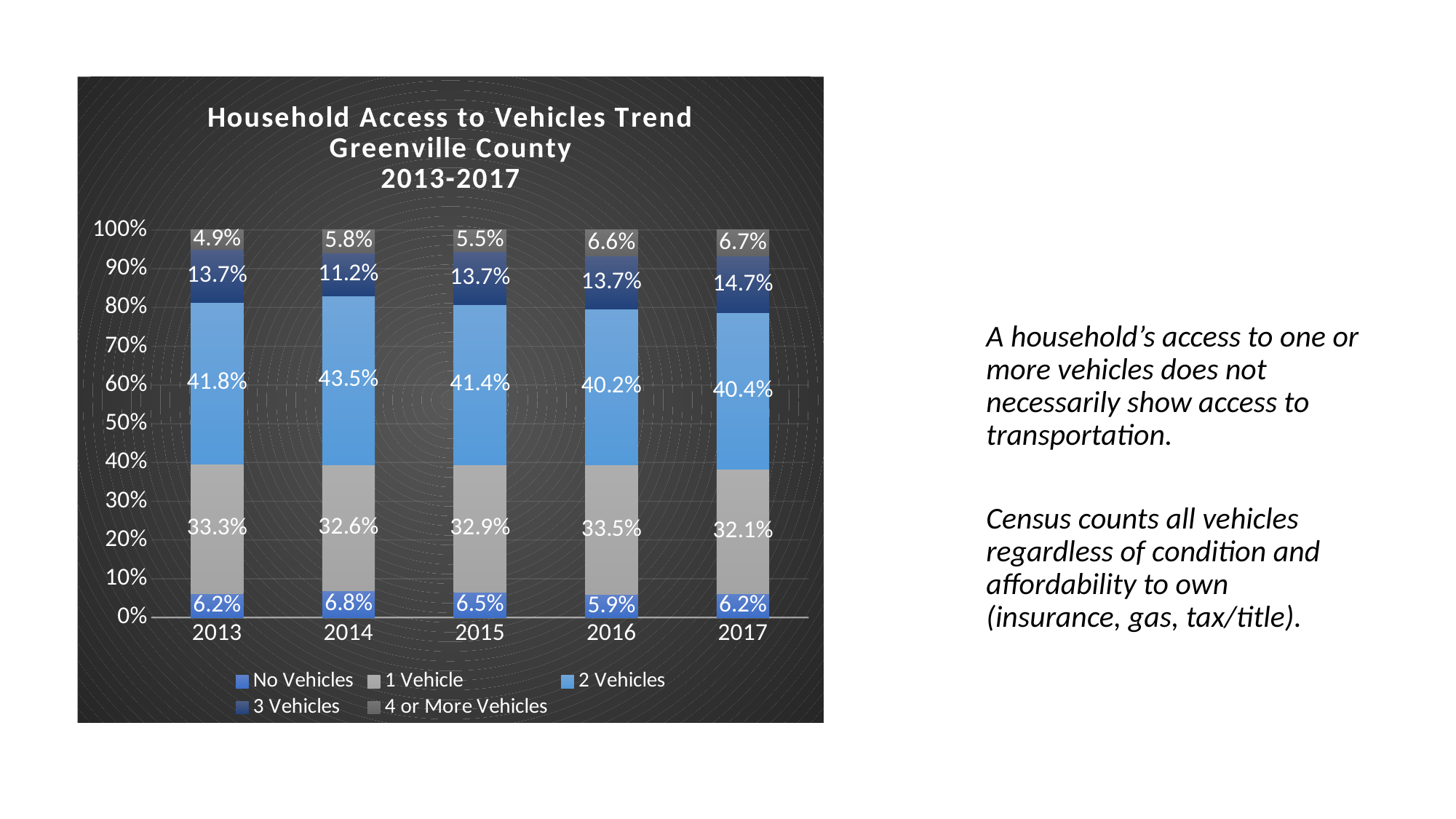
How many years are shown on the x axis? 5 In which year was the 3 Vehicles share the lowest? 2014 By how many percentage points did the 2 Vehicles share in 2014 exceed that in 2017? 3.1 percentage points Which year had a larger 1 Vehicle share, 2013 or 2016? 2016 In which year was the 4 or More Vehicles share the highest? 2017 What kind of chart is shown on the slide? Stacked bar chart What is the title of the chart? Household Access to Vehicles Trend Greenville County 2013-2017 What is the value for No Vehicles in 2016? 5.9% What percentage of households had 2 Vehicles in 2014? 43.5% What share of households had 1 Vehicle in 2017? 32.1% Does the 4 or More Vehicles share rise or fall from 2015 to 2017? Rise How many series does the legend list? 5